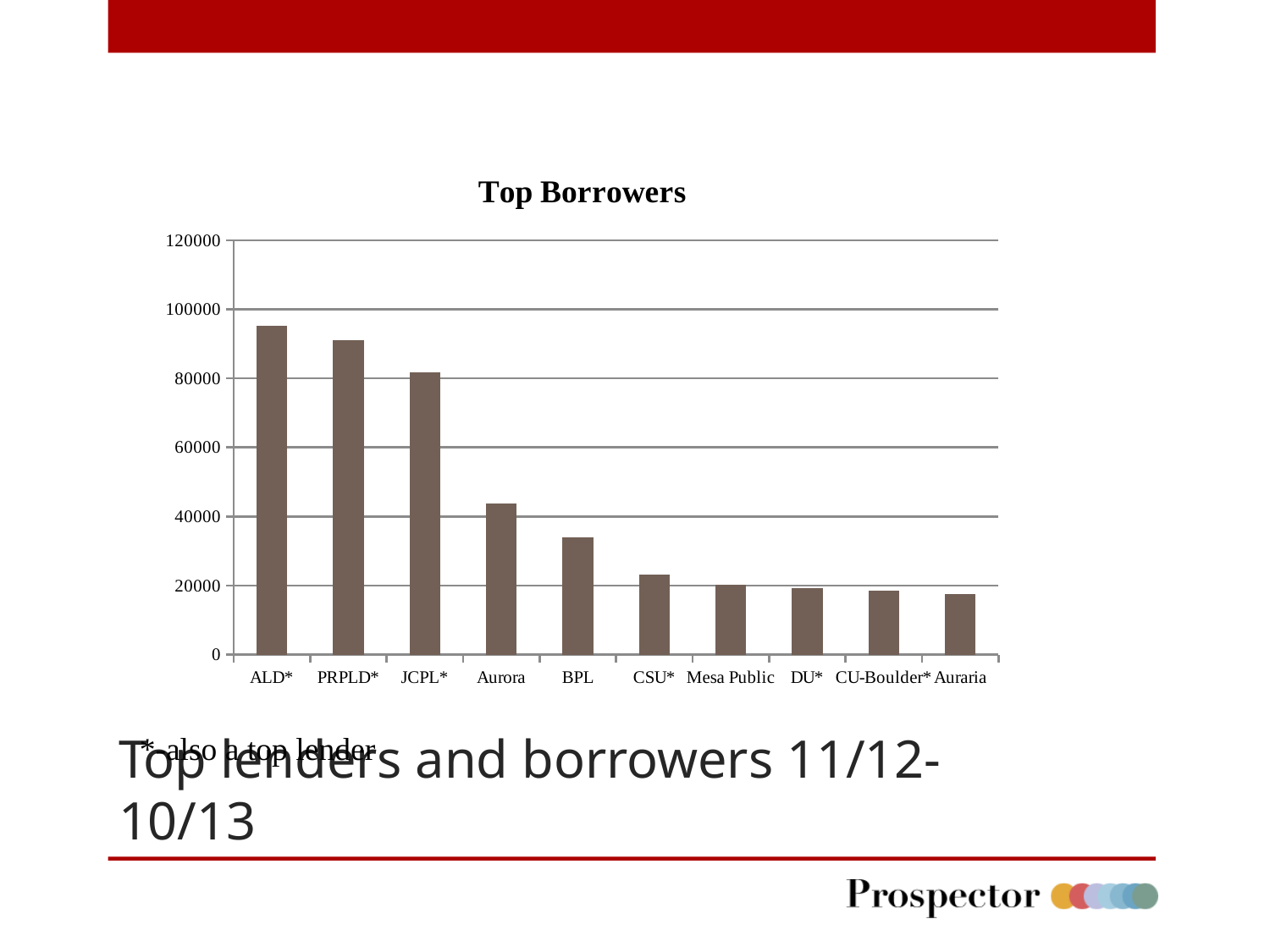
Do the values rise or fall moving from left to right across the chart? fall How many borrowers are shown in the chart? 10 Which borrower has the highest value in the chart? ALD* Is the value for PRPLD* greater or less than 100000? less Is the value for Aurora greater or less than 40000? greater According to the note on the slide, what does the asterisk after a borrower's name indicate? also a top lender Is the value for BPL greater or less than 40000? less Which has a larger value, Aurora or BPL? Aurora What is the title of the chart? Top Borrowers What kind of chart is shown on the slide? bar chart